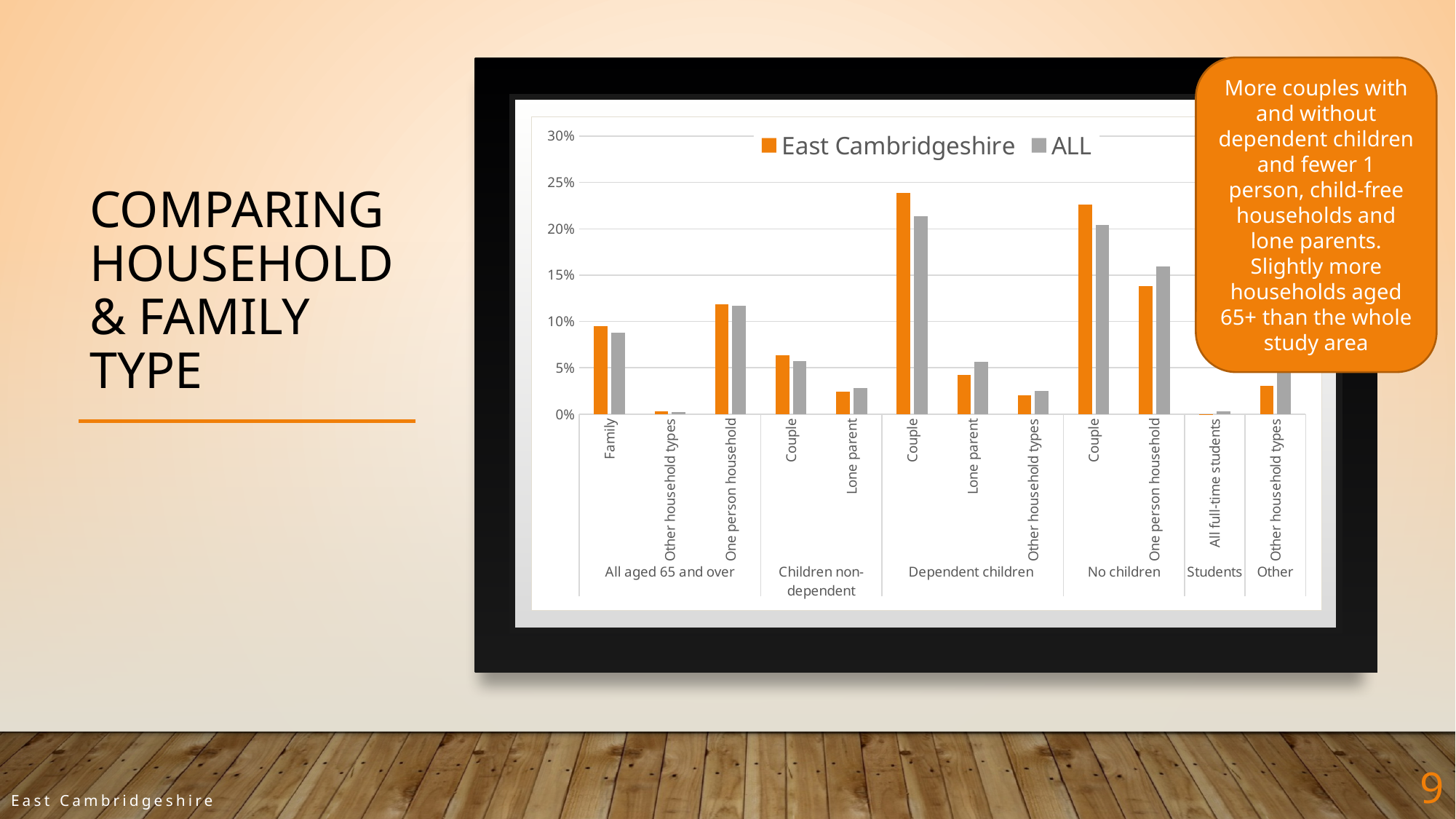
For Couple under Dependent children, which series has the larger value, East Cambridgeshire or ALL? East Cambridgeshire For Lone parent under Dependent children, which series has the larger value, East Cambridgeshire or ALL? ALL Is the East Cambridgeshire value for Couple under Dependent children greater or less than 20%? greater Is the East Cambridgeshire value for Family under All aged 65 and over greater or less than 10%? less What kind of chart is shown on the slide? Bar chart How many household-type categories are plotted along the x axis of the chart? 12 What are the two series named in the chart legend? East Cambridgeshire and ALL Is the ALL value for One person household under No children greater or less than 15%? greater How many series does the chart legend list? 2 Which category has the lowest East Cambridgeshire value in the chart? All full-time students Which category has the highest East Cambridgeshire value in the chart? Couple (Dependent children) For One person household under No children, which series has the larger value, East Cambridgeshire or ALL? ALL